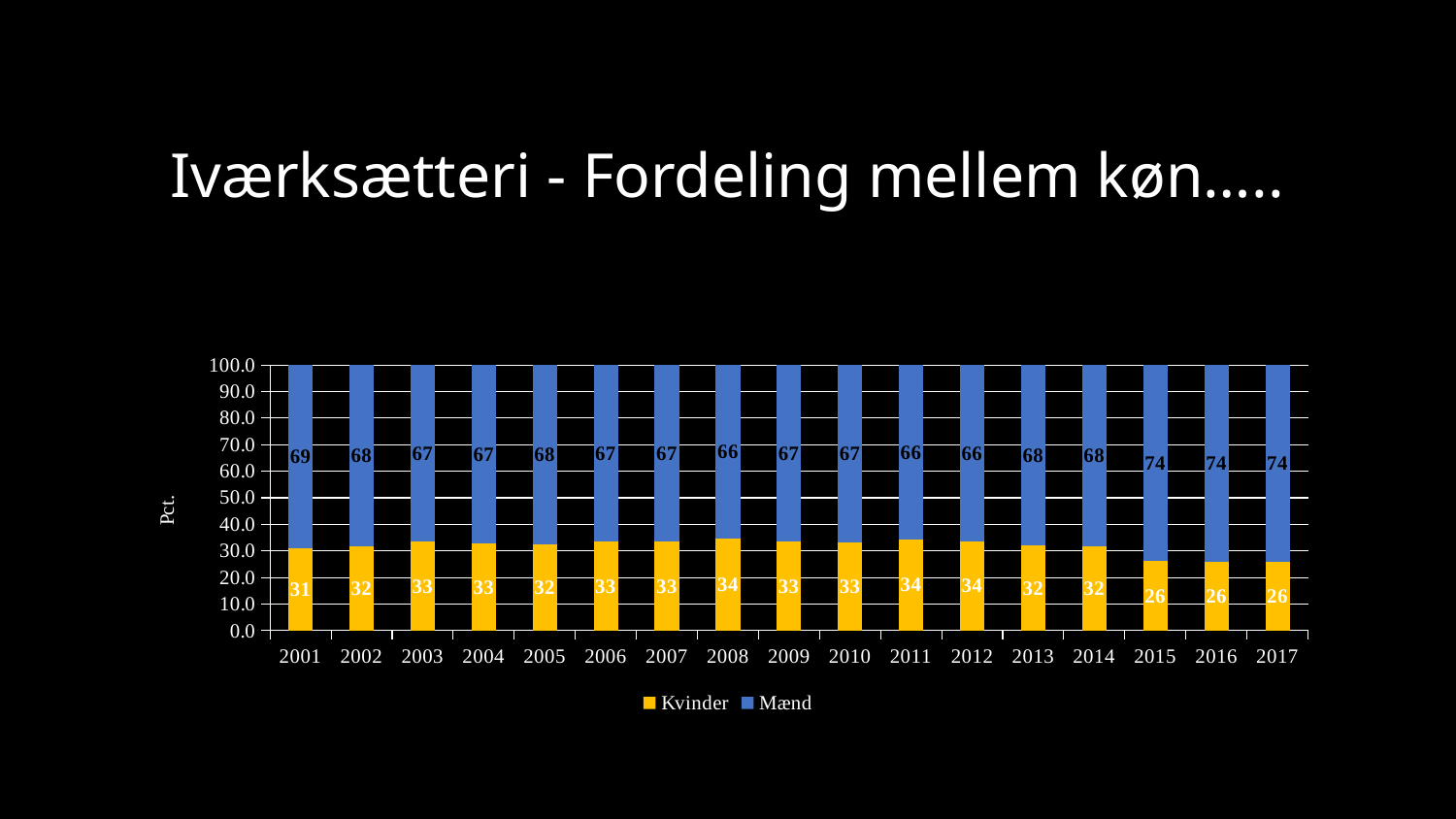
What is the difference between the Mænd and Kvinder values in 2016? 48 What is the value for Mænd in 2017? 74 What is the label of the y axis? Pct. In which year is the Mænd value highest (first occurrence)? 2015 What kind of chart is shown on the slide? Stacked bar chart In which year is the Kvinder value lowest (first occurrence)? 2015 What is the total of the stacked bar for 2005? 100 How many years are shown on the x axis? 17 Which is larger in 2010: the Kvinder value or the Mænd value? Mænd What is the value for Kvinder in 2008? 34 What is the value for Kvinder in 2001? 31 How many series does the legend list? 2